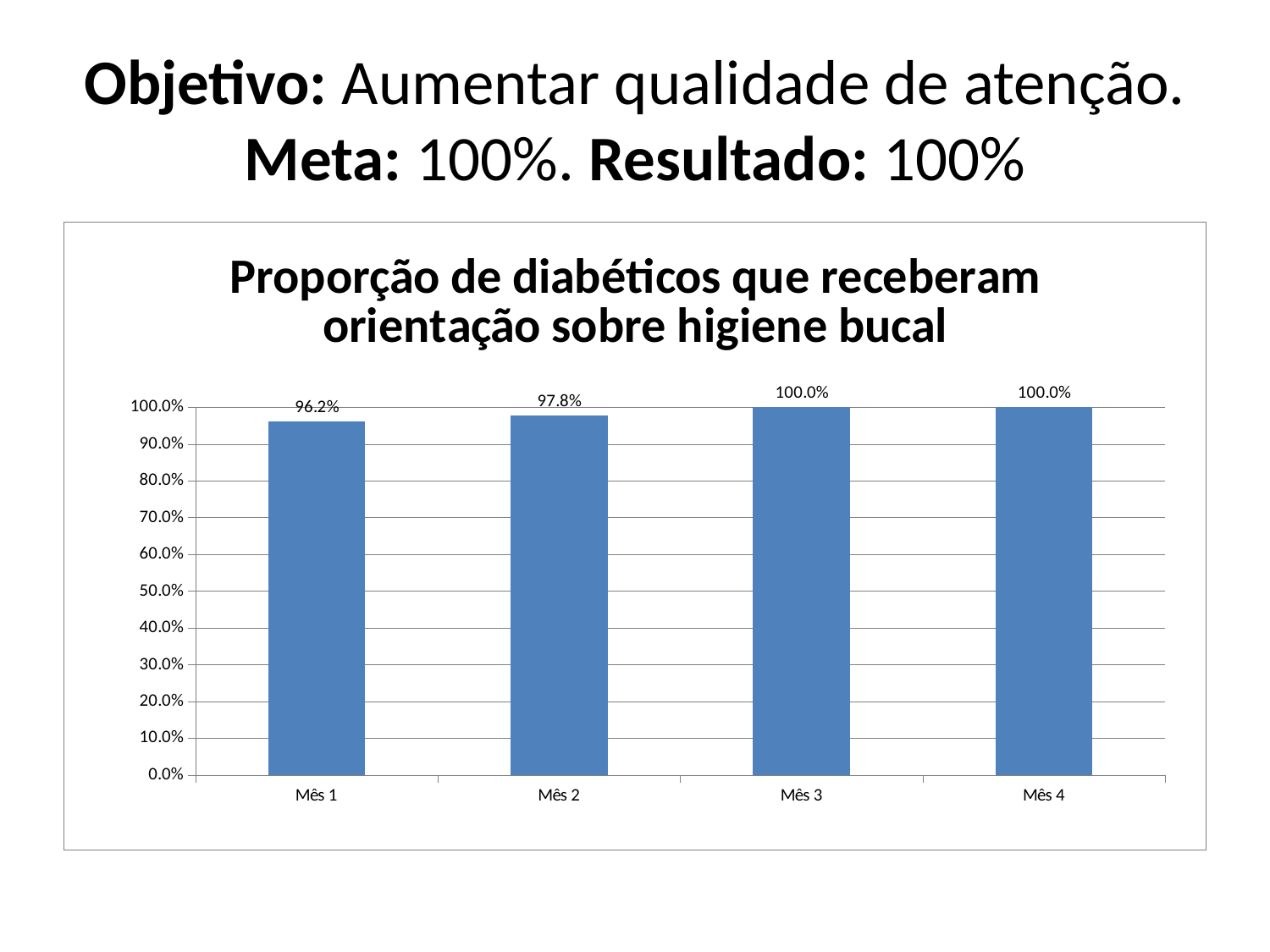
Which month has the lowest value? Mês 1 What kind of chart is shown on the slide? Bar chart Do the values rise or fall from Mês 1 to Mês 4? Rise How many months are shown on the x axis? 4 What is the difference between the values for Mês 3 and Mês 1? 3.8% What is the difference between the values for Mês 2 and Mês 1? 1.6% What is the value for Mês 2? 97.8% What is the value for Mês 1? 96.2% Is the value for Mês 1 greater or less than 90.0%? greater Which is larger, the value for Mês 1 or the value for Mês 2? Mês 2 What is the value for Mês 4? 100.0% What is the value for Mês 3? 100.0%